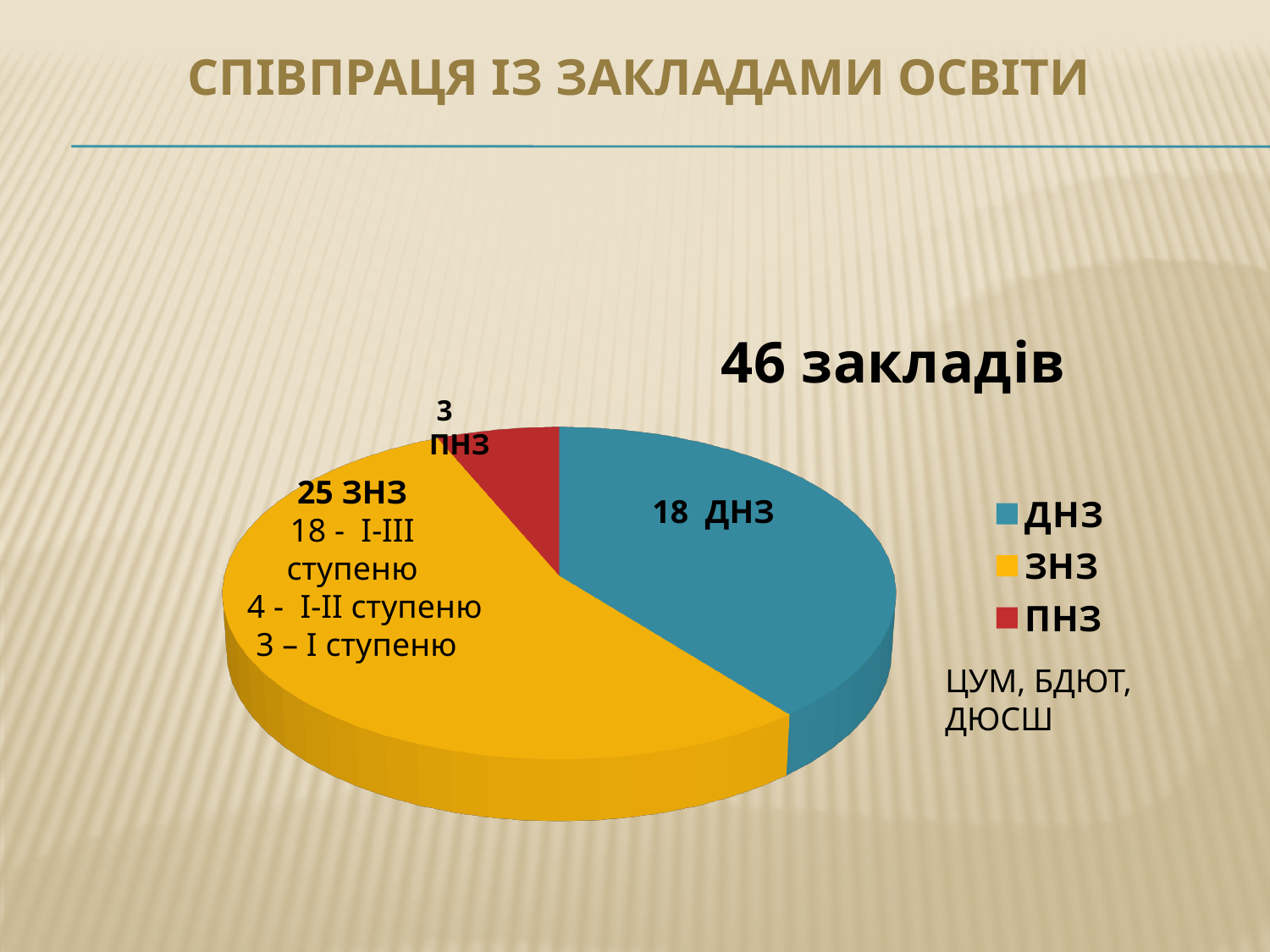
What is the total number of establishments shown on the slide? 46 закладів Which is larger, the value for ДНЗ or the value for ПНЗ? ДНЗ What kind of chart is shown on the slide? pie chart How many series does the legend list? 3 What is the value for ПНЗ? 3 Which colour represents ЗНЗ in the pie chart? yellow What is the value for ДНЗ? 18 How many slices does the pie chart have? 3 What is the value for ЗНЗ? 25 Which category has the largest slice? ЗНЗ What is the difference between the values for ЗНЗ and ДНЗ? 7 Which category has the smallest slice? ПНЗ